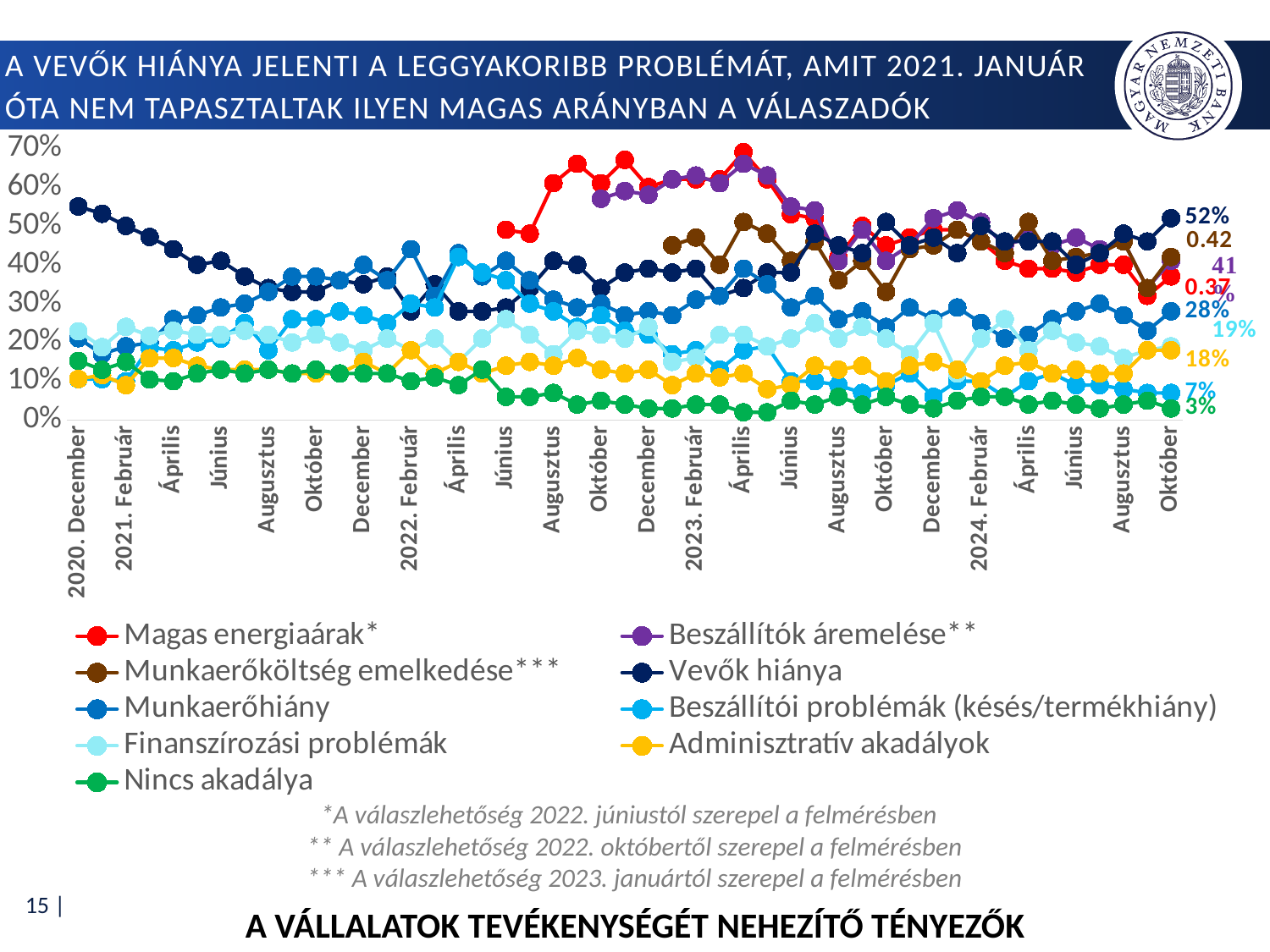
Which series has the lowest value at the last data point (Október 2024)? Nincs akadálya What is the difference between Vevők hiánya and Munkaerőhiány at the last data point (Október 2024)? 24 percentage points What kind of chart is shown on the slide? line chart Is the value of Vevők hiánya in 2020. December greater or less than 50%? greater Does the Nincs akadálya series rise or fall from 2020. December to Október 2024? fall What is the value of Nincs akadálya at the last data point (Október 2024)? 3% What is the value of Munkaerőhiány at the last data point (Október 2024)? 28% What is the value of Vevők hiánya at the last data point (Október 2024)? 52% How many series does the legend list? 9 What is the value of Beszállítói problémák (késés/termékhiány) at the last data point (Október 2024)? 7% What is the value of Adminisztratív akadályok at the last data point (Október 2024)? 18% Which series has the highest value at the last data point (Október 2024)? Vevők hiánya